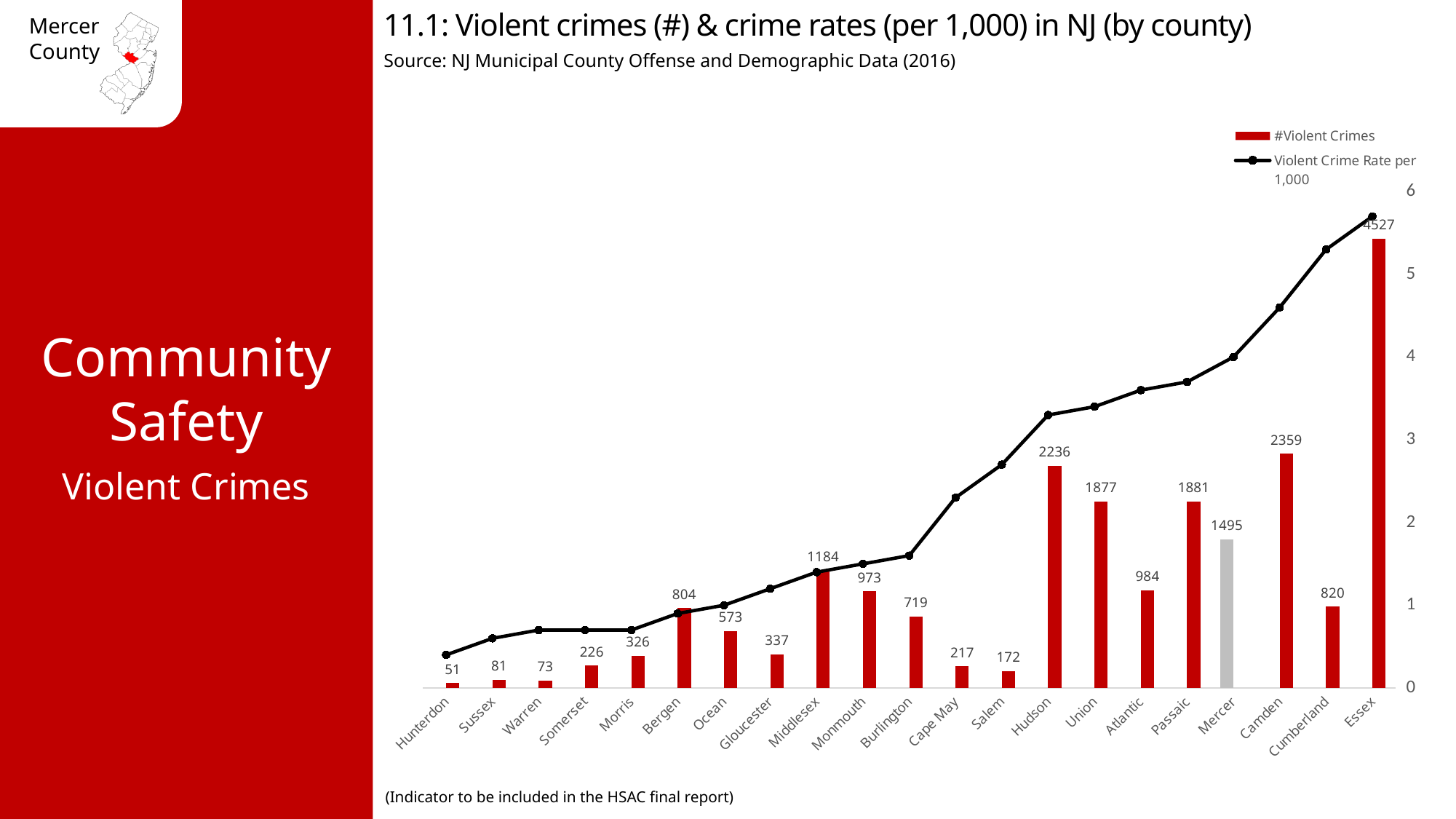
Which county has more violent crimes, Union or Passaic? Passaic Does the violent crime rate per 1,000 line generally rise or fall from Hunterdon to Essex? Rise Which county has the lowest number of violent crimes? Hunterdon What is the difference in the number of violent crimes between Camden and Mercer? 864 What kind of chart is used to show the number of violent crimes? Bar chart How many counties are shown on the x axis? 21 Is the violent crime rate per 1,000 for Hunterdon greater or less than 1? less What is the number of violent crimes for Hudson County? 2236 How many series does the legend list? 2 Which county has the highest number of violent crimes? Essex Is the violent crime rate per 1,000 for Essex greater or less than 5? greater What is the number of violent crimes for Mercer County? 1495